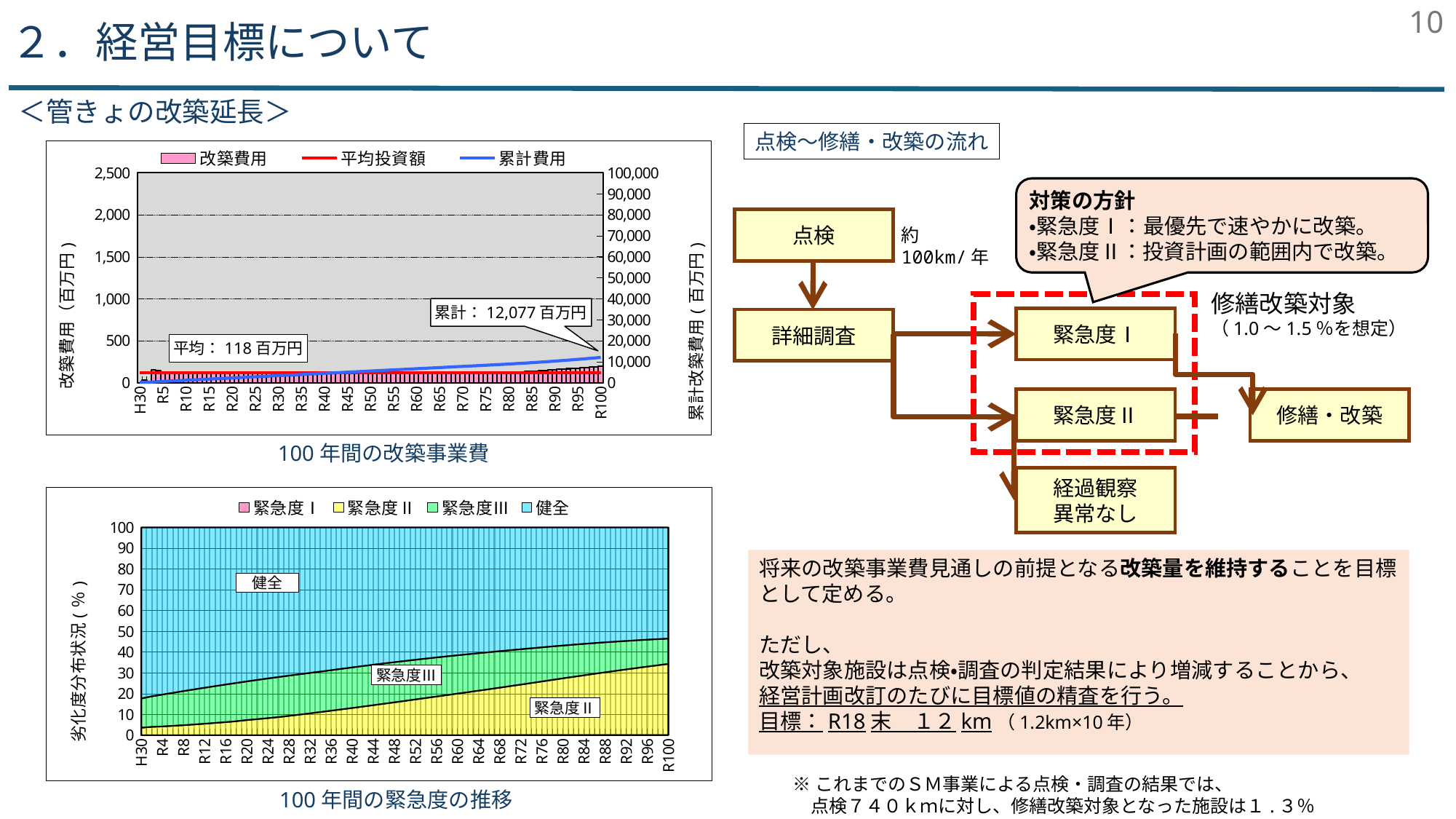
In the chart titled 100年間の緊急度の推移, how many series does the legend list? 4 In the chart titled 100年間の改築事業費, which legend entry is drawn as pink bars? 改築費用 What kind of chart is the one titled 100年間の緊急度の推移? stacked area chart In the chart titled 100年間の改築事業費, how many series does the legend list? 3 In the chart titled 100年間の改築事業費, what is the 平均 (average) value shown in the annotation? 118 百万円 In the chart titled 100年間の緊急度の推移, does the share of 緊急度Ⅱ rise or fall from H30 to R100? rises In the chart titled 100年間の緊急度の推移, does the share of 健全 rise or fall from H30 to R100? falls In the chart titled 100年間の緊急度の推移, which series has the largest share at H30? 健全 In the chart titled 100年間の改築事業費, does the 累計費用 line rise or fall from H30 to R100? rises In the chart titled 100年間の改築事業費, what is the maximum value shown on the left vertical axis? 2,500 In the chart titled 100年間の緊急度の推移, is the share of 緊急度Ⅱ at R100 greater or less than 40? less In the chart titled 100年間の改築事業費, what is the 累計 (cumulative) value shown in the annotation? 12,077 百万円